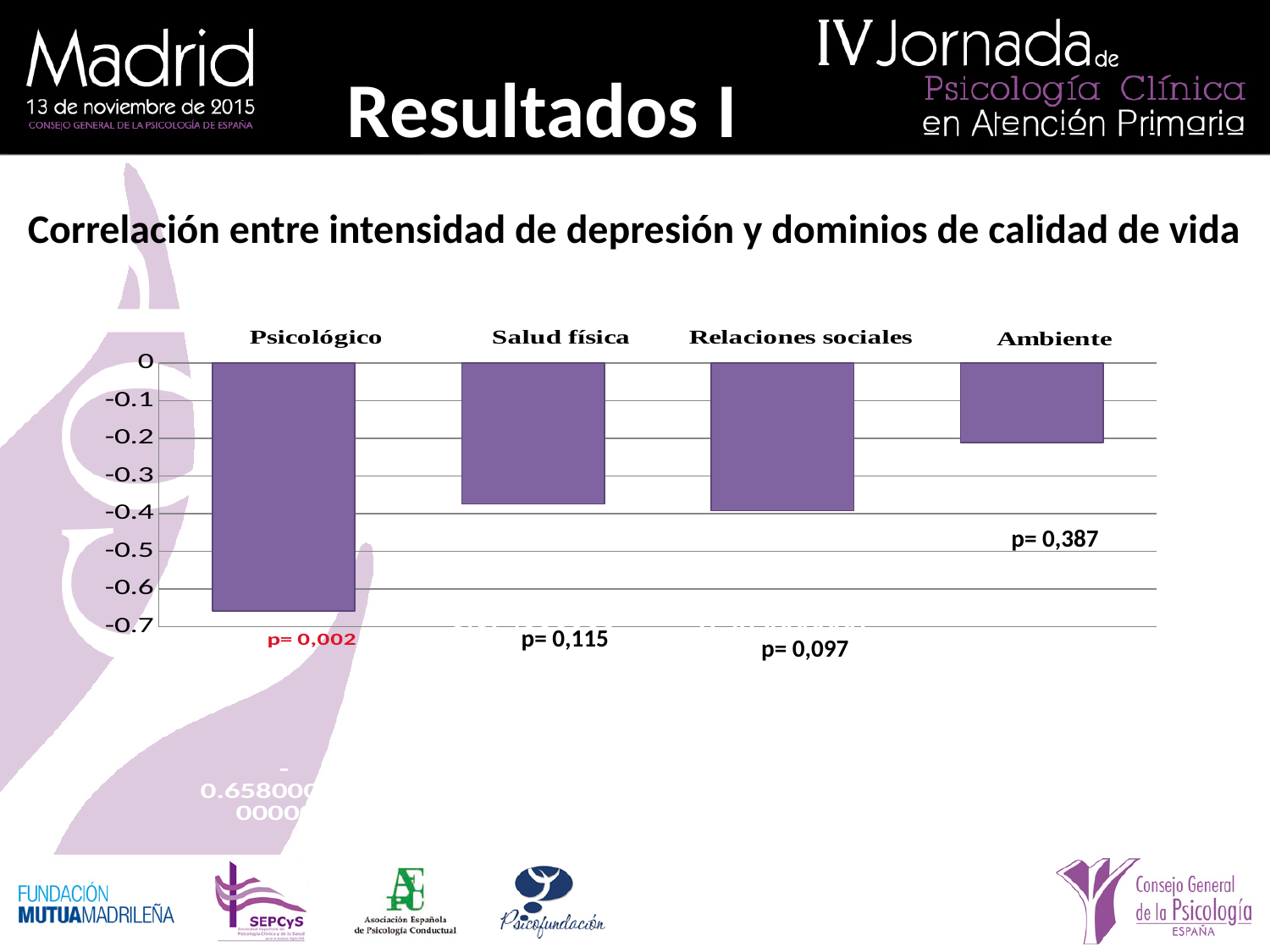
What is the title of the chart on the slide? Correlación entre intensidad de depresión y dominios de calidad de vida What kind of chart is shown on the slide? bar chart What p-value is printed for the Ambiente category? p= 0,387 Is the value for Psicológico greater or less than -0.6? less Which category has the highest value (closest to zero) in the chart? Ambiente Is the value for Relaciones sociales greater or less than -0.3? less Is the value for Salud física greater or less than -0.3? less Which category has the lowest (most negative) value in the chart? Psicológico What p-value is printed for the Psicológico category? p= 0,002 Which is larger, the value for Ambiente or the value for Psicológico? Ambiente How many categories (domains) are plotted in the chart? 4